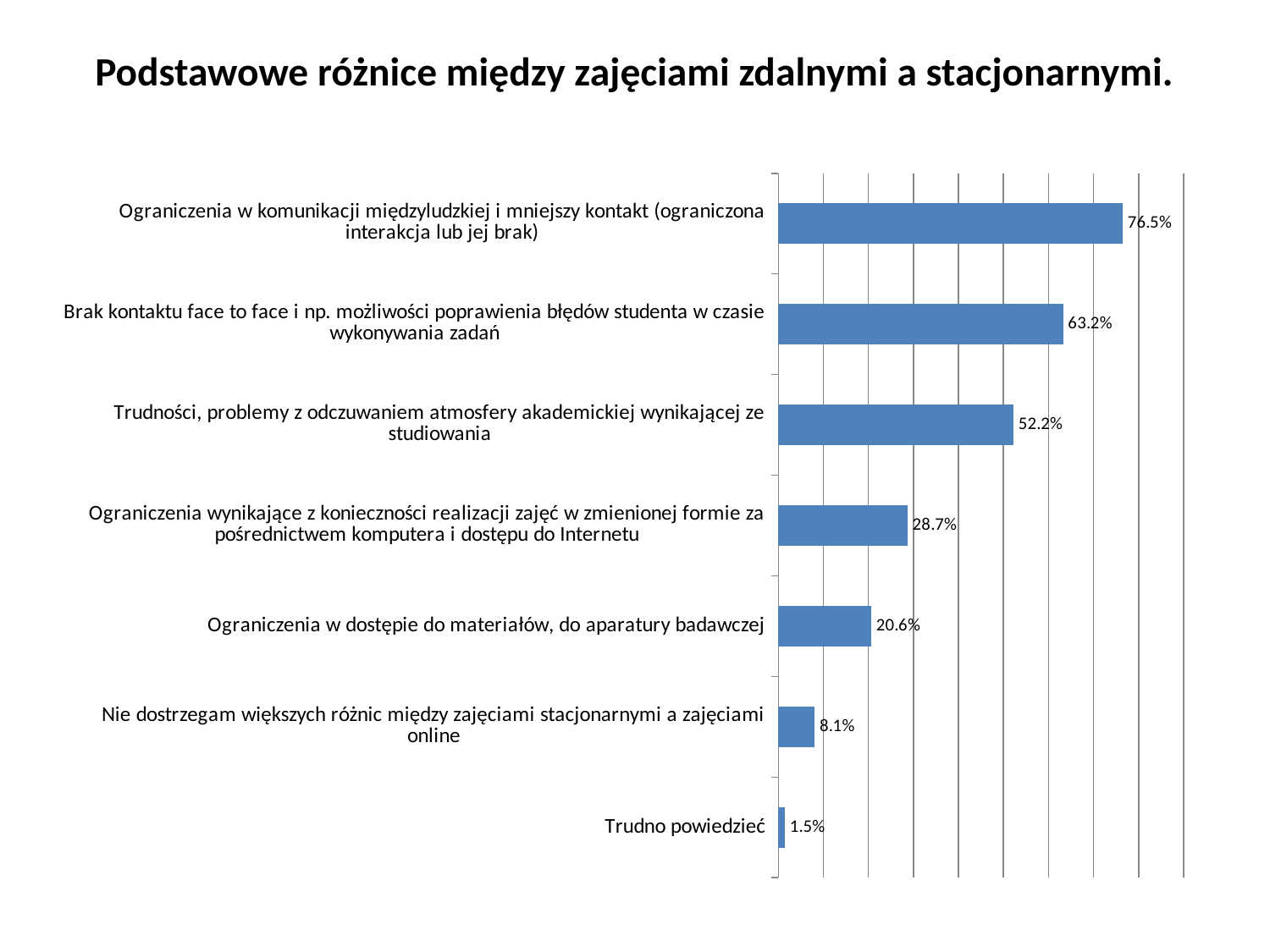
Which category has the highest value? Ograniczenia w komunikacji międzyludzkiej i mniejszy kontakt (ograniczona interakcja lub jej brak) How many categories are shown in the chart? 7 Which category has the lowest value? Trudno powiedzieć What is the title of the slide? Podstawowe różnice między zajęciami zdalnymi a stacjonarnymi. What is the value for "Trudności, problemy z odczuwaniem atmosfery akademickiej wynikającej ze studiowania"? 52.2% What is the value for "Ograniczenia w dostępie do materiałów, do aparatury badawczej"? 20.6% What is the difference between the values for "Ograniczenia w komunikacji międzyludzkiej i mniejszy kontakt (ograniczona interakcja lub jej brak)" and "Brak kontaktu face to face i np. możliwości poprawienia błędów studenta w czasie wykonywania zadań"? 13.3% Which is larger: the value for "Brak kontaktu face to face i np. możliwości poprawienia błędów studenta w czasie wykonywania zadań" or the value for "Trudności, problemy z odczuwaniem atmosfery akademickiej wynikającej ze studiowania"? Brak kontaktu face to face i np. możliwości poprawienia błędów studenta w czasie wykonywania zadań What kind of chart is shown on the slide? Bar chart What is the value for "Nie dostrzegam większych różnic między zajęciami stacjonarnymi a zajęciami online"? 8.1% What is the difference between the values for "Ograniczenia wynikające z konieczności realizacji zajęć w zmienionej formie za pośrednictwem komputera i dostępu do Internetu" and "Ograniczenia w dostępie do materiałów, do aparatury badawczej"? 8.1% What is the value for "Trudno powiedzieć"? 1.5%